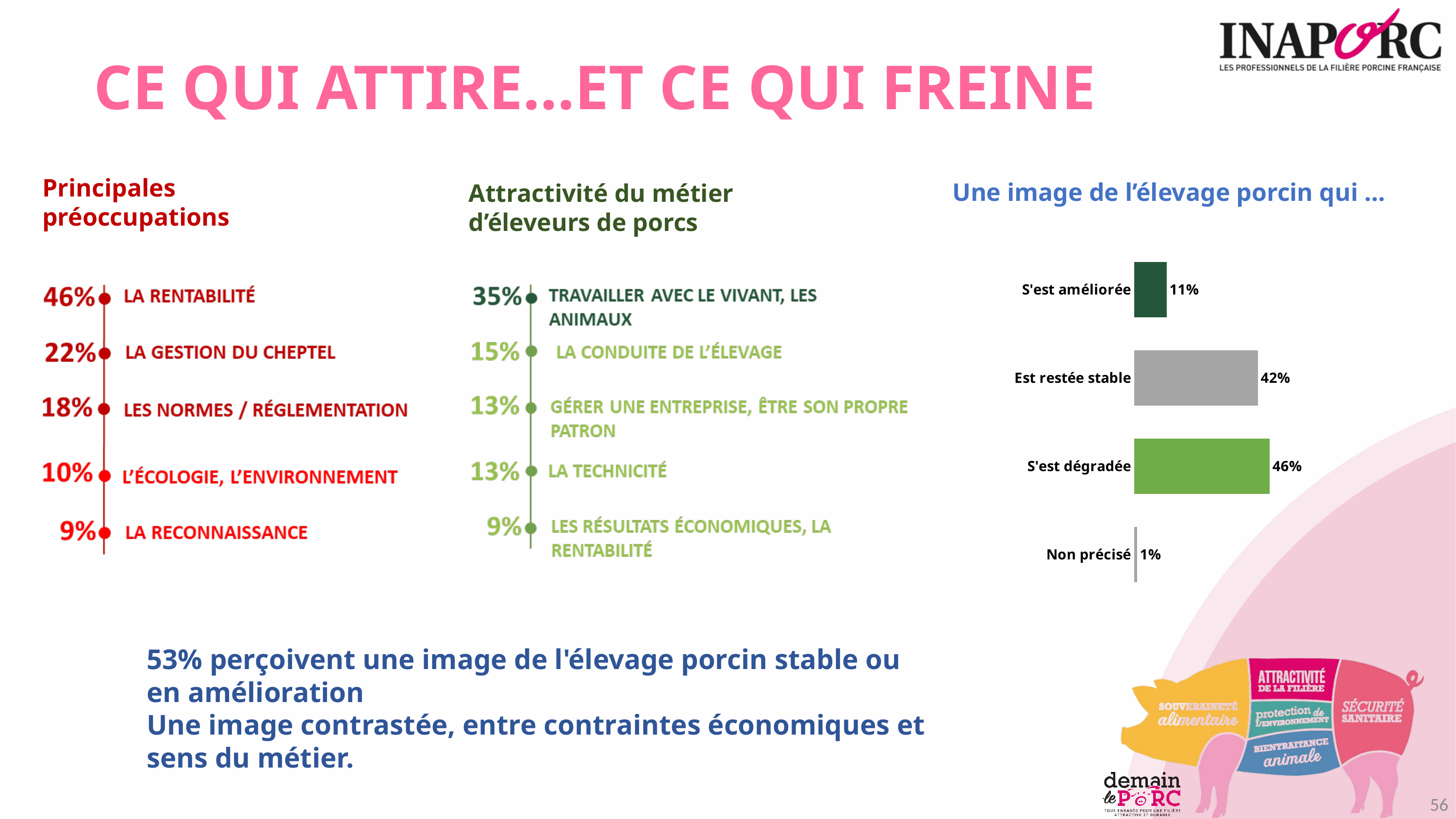
In the chart 'Une image de l'élevage porcin qui ...', which category has the highest value? S'est dégradée In the chart 'Une image de l'élevage porcin qui ...', what is the value for 'Non précisé'? 1% In the chart 'Une image de l'élevage porcin qui ...', what is the value for 'S'est améliorée'? 11% What kind of chart is 'Une image de l'élevage porcin qui ...'? Bar chart In the chart 'Une image de l'élevage porcin qui ...', which category has the lowest value? Non précisé In the 'Attractivité du métier d'éleveurs de porcs' list in the middle, what percentage is given for 'Travailler avec le vivant, les animaux'? 35% In the chart 'Une image de l'élevage porcin qui ...', what is the value for 'Est restée stable'? 42% In the chart 'Une image de l'élevage porcin qui ...', what is the difference between 'S'est dégradée' and 'S'est améliorée'? 35% In the chart 'Une image de l'élevage porcin qui ...', what colour is the bar for 'S'est dégradée'? Green In the chart 'Une image de l'élevage porcin qui ...', which is larger: 'Est restée stable' or 'S'est améliorée'? Est restée stable How many categories are shown in the chart 'Une image de l'élevage porcin qui ...'? 4 In the 'Principales préoccupations' list on the left, what percentage is given for 'La rentabilité'? 46%